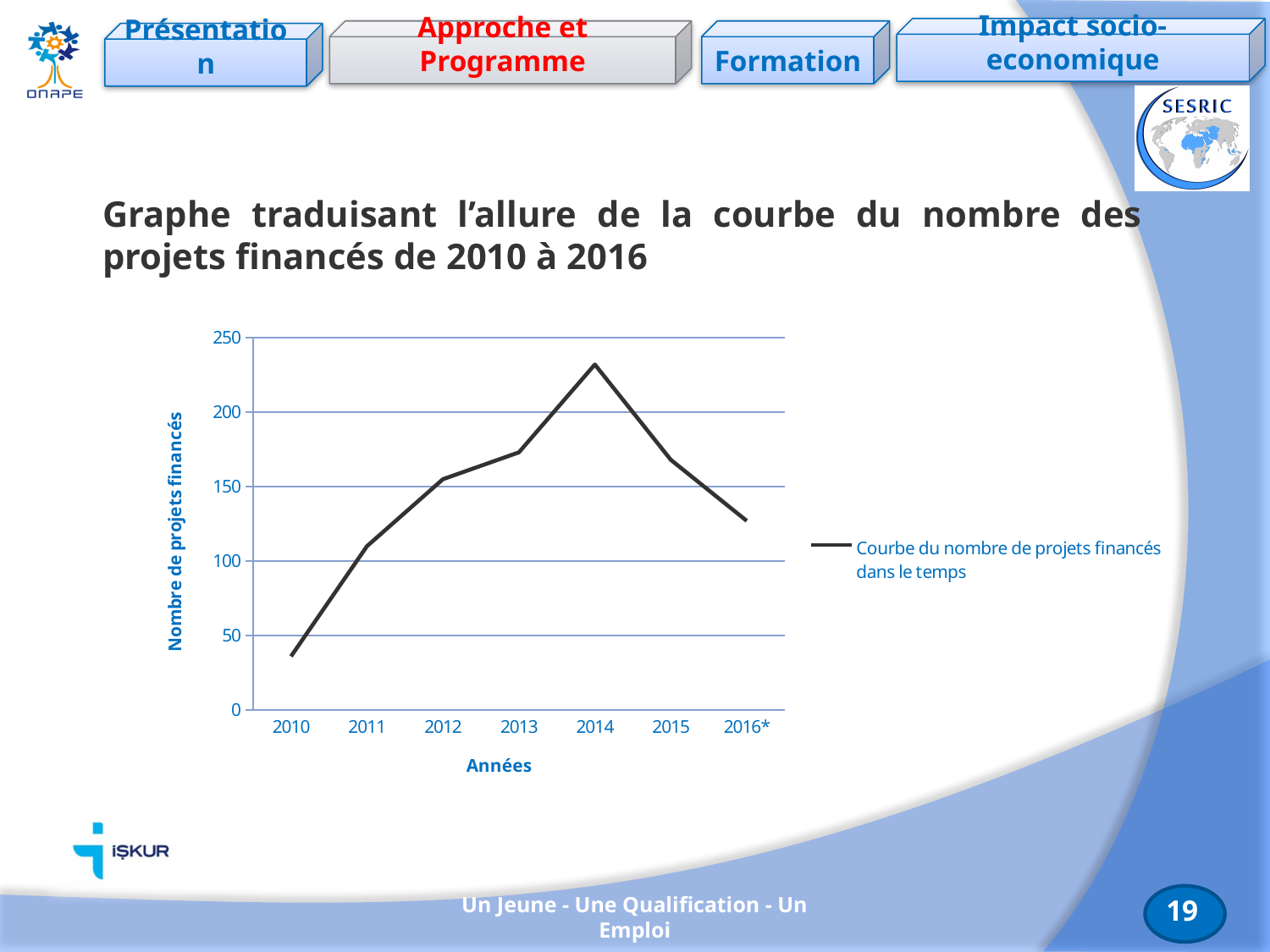
How many years are plotted on the x axis of the chart? 7 Is the value for 2016* greater or less than 100? greater Is the value for 2010 greater or less than 50? less In which year is the number of projets financés lowest? 2010 Is the value for 2014 greater or less than 200? greater Does the number of projets financés rise or fall from 2014 to 2016*? fall Which year has the larger value, 2011 or 2015? 2015 How many series does the chart's legend list? 1 In which year is the number of projets financés highest? 2014 What kind of chart is shown on the slide? line chart What is the title of the y axis of the chart? Nombre de projets financés